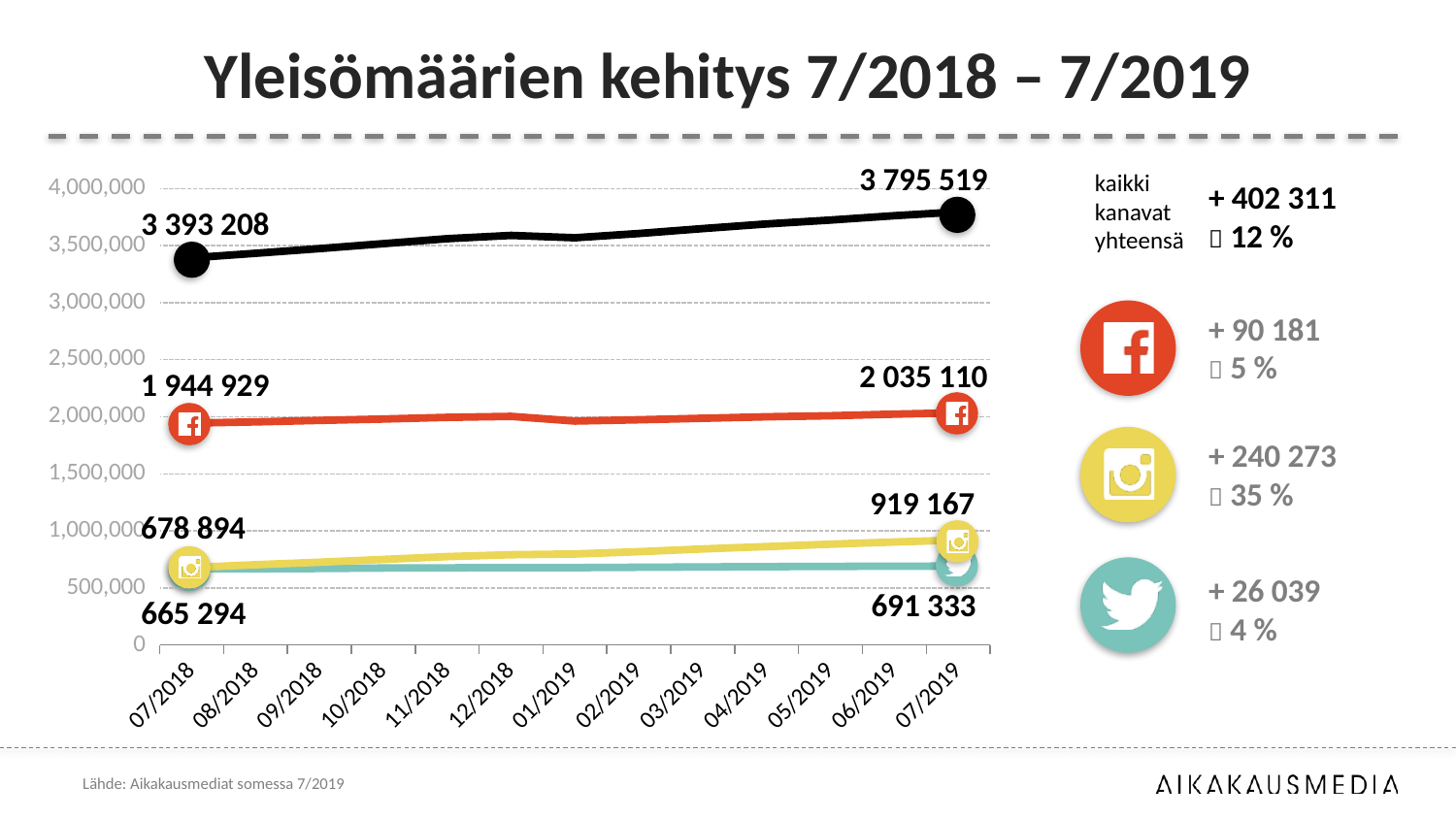
Which line has the highest value at 07/2019? the black (total) line What is the difference between the Facebook line's values at 07/2019 and 07/2018? 90 181 Does the Instagram (yellow) line rise or fall from 07/2018 to 07/2019? rise What is the value of the black (total) line at 07/2018? 3 393 208 What is the value of the black (total) line at 07/2019? 3 795 519 Which line has the lowest value at 07/2018? the Twitter (teal) line How many months are shown on the x axis? 13 What is the value of the Instagram (yellow) line at 07/2018? 678 894 What is the value of the Twitter (teal) line at 07/2019? 691 333 Is the Facebook (red) line's value at 07/2019 greater or less than the Instagram (yellow) line's value at 07/2019? greater What type of chart is shown on the slide? line chart What is the value of the Facebook (red) line at 07/2019? 2 035 110